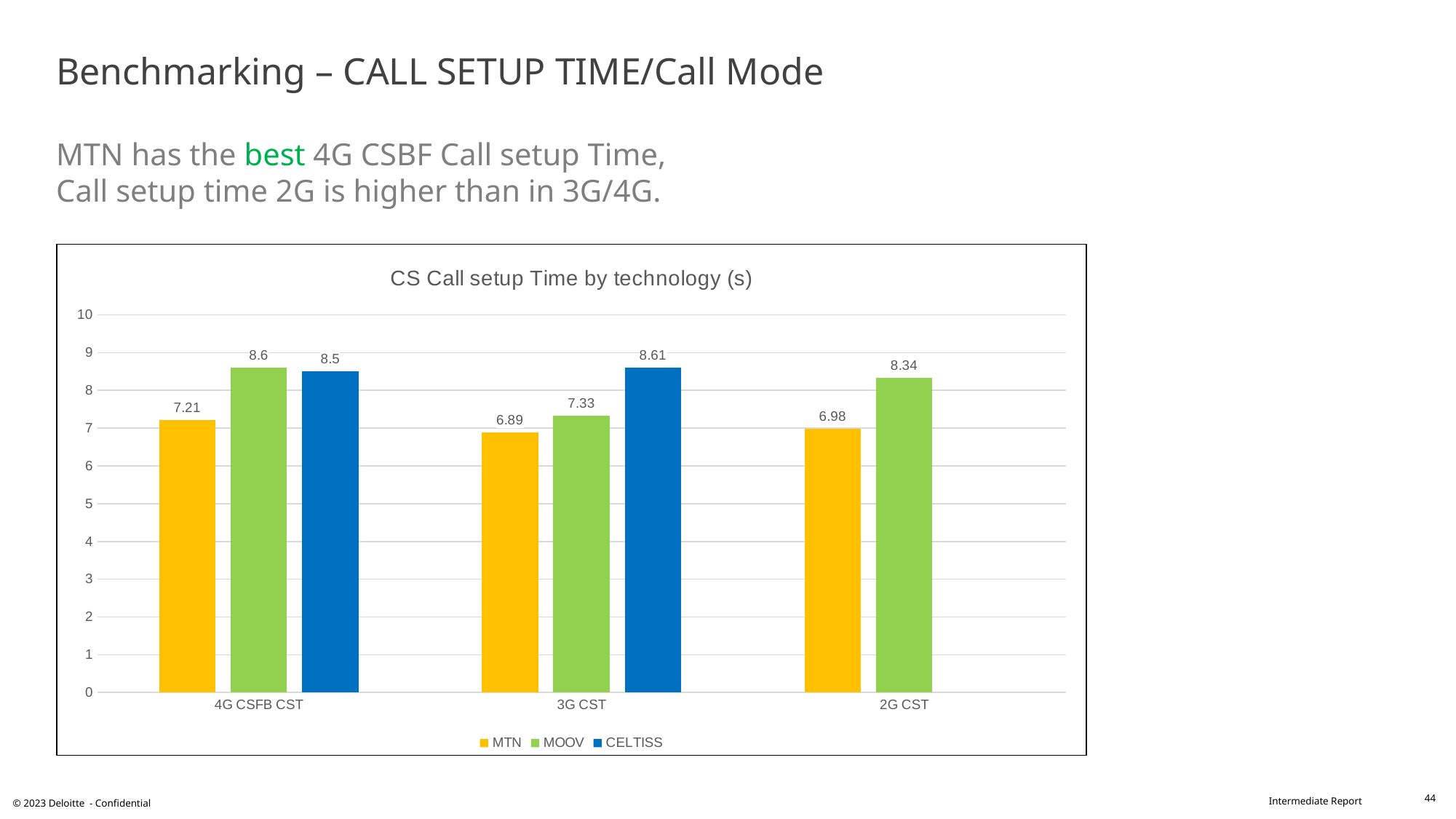
How many technology categories are shown on the x axis? 3 What is the difference between the MOOV and MTN values for 3G CST? 0.44 What is the MTN value for 4G CSFB CST? 7.21 Is the CELTISS value for 4G CSFB CST greater or less than 8? greater Which operator has the lowest call setup time for 3G CST? MTN Which operator has the highest call setup time for 4G CSFB CST? MOOV How many series does the legend list? 3 What is the CELTISS value for 3G CST? 8.61 What kind of chart is shown on the slide? bar chart What is the title of the chart? CS Call setup Time by technology (s) Which is larger, the MTN value for 4G CSFB CST or the MTN value for 2G CST? 4G CSFB CST What is the MOOV value for 2G CST? 8.34